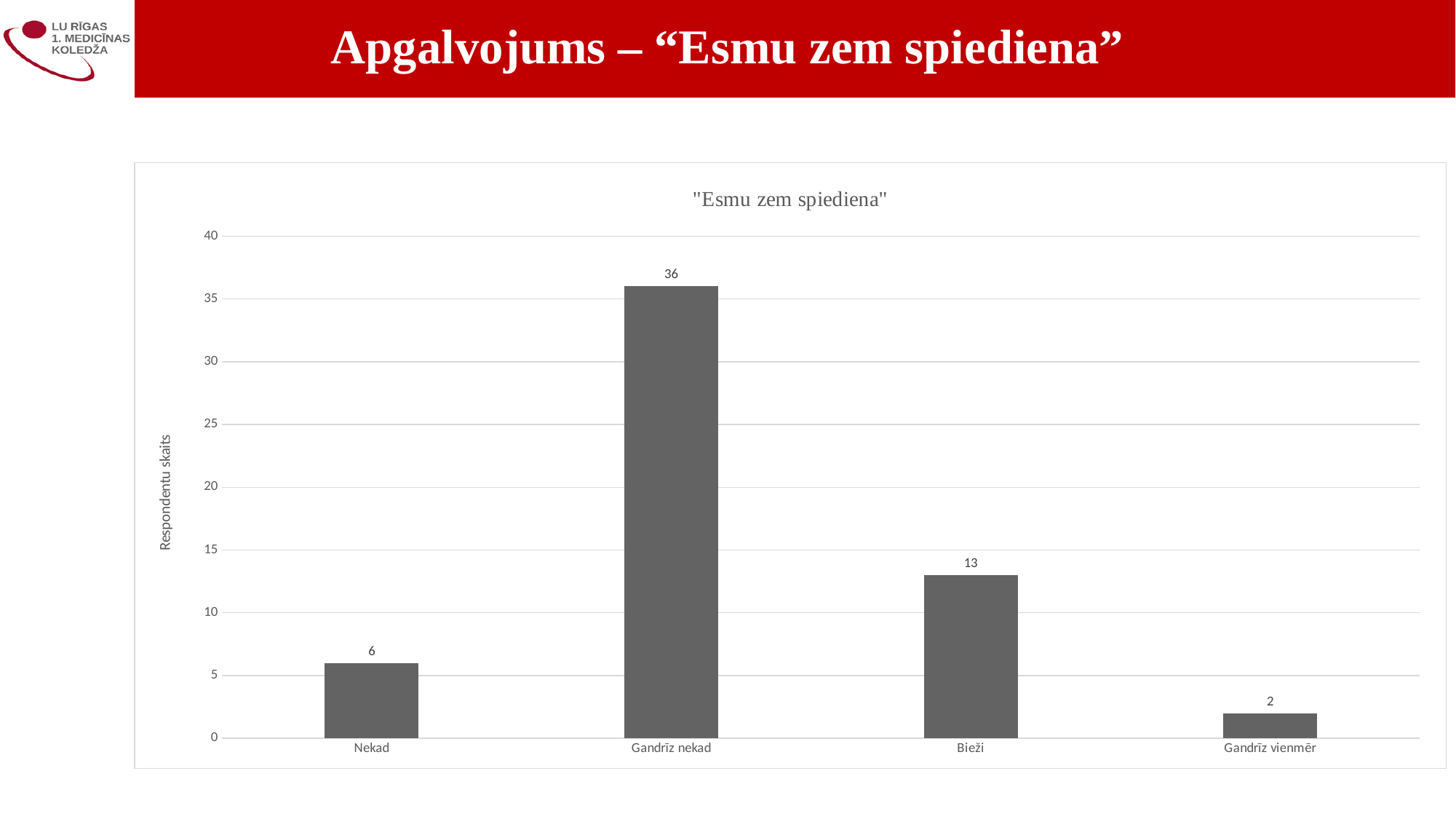
What is the value for Bieži? 13 What is the label of the vertical axis? Respondentu skaits What kind of chart is shown on the slide? bar chart Is the value for Gandrīz nekad greater or less than 30? greater What is the value for Gandrīz nekad? 36 What is the difference between the values for Gandrīz nekad and Bieži? 23 How many categories are shown on the x axis? 4 Which is larger, the value for Nekad or the value for Bieži? Bieži What is the value for Gandrīz vienmēr? 2 Which category has the highest value? Gandrīz nekad What is the value for Nekad? 6 Which category has the lowest value? Gandrīz vienmēr